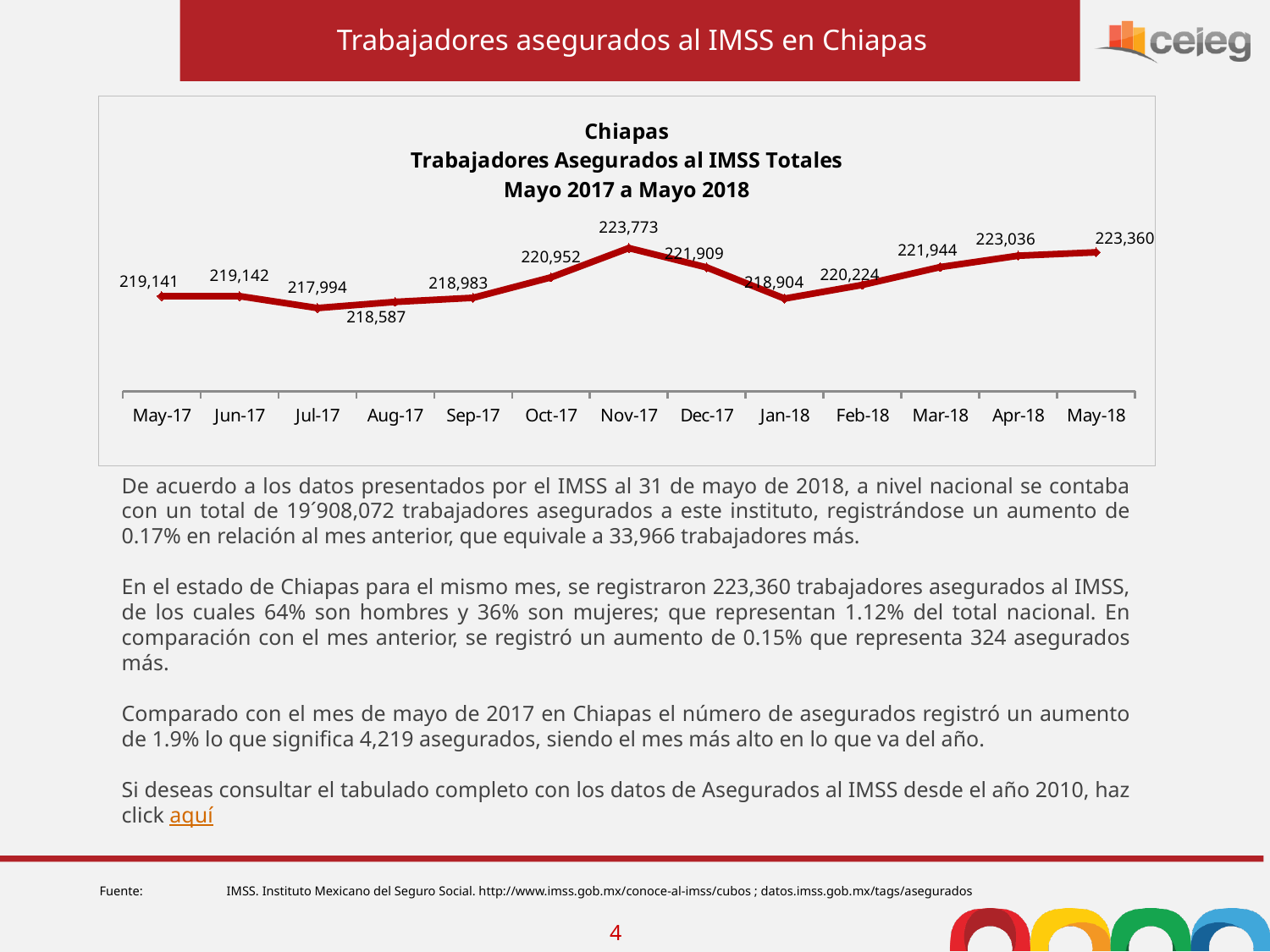
What is the value for Jul-17? 217,994 What is the difference between the values for May-18 and May-17? 4,219 What is the value for May-18? 223,360 Which month has the lowest value? Jul-17 Which month has the highest value? Nov-17 How many months are plotted on the chart? 13 What is the value for Nov-17? 223,773 Which is larger, the value for Dec-17 or the value for Jan-18? Dec-17 What is the value for Jan-18? 218,904 Do the values rise or fall from Jan-18 to May-18? Rise What is the difference between the values for Nov-17 and Jul-17? 5,779 What type of chart is shown on the slide? Line chart